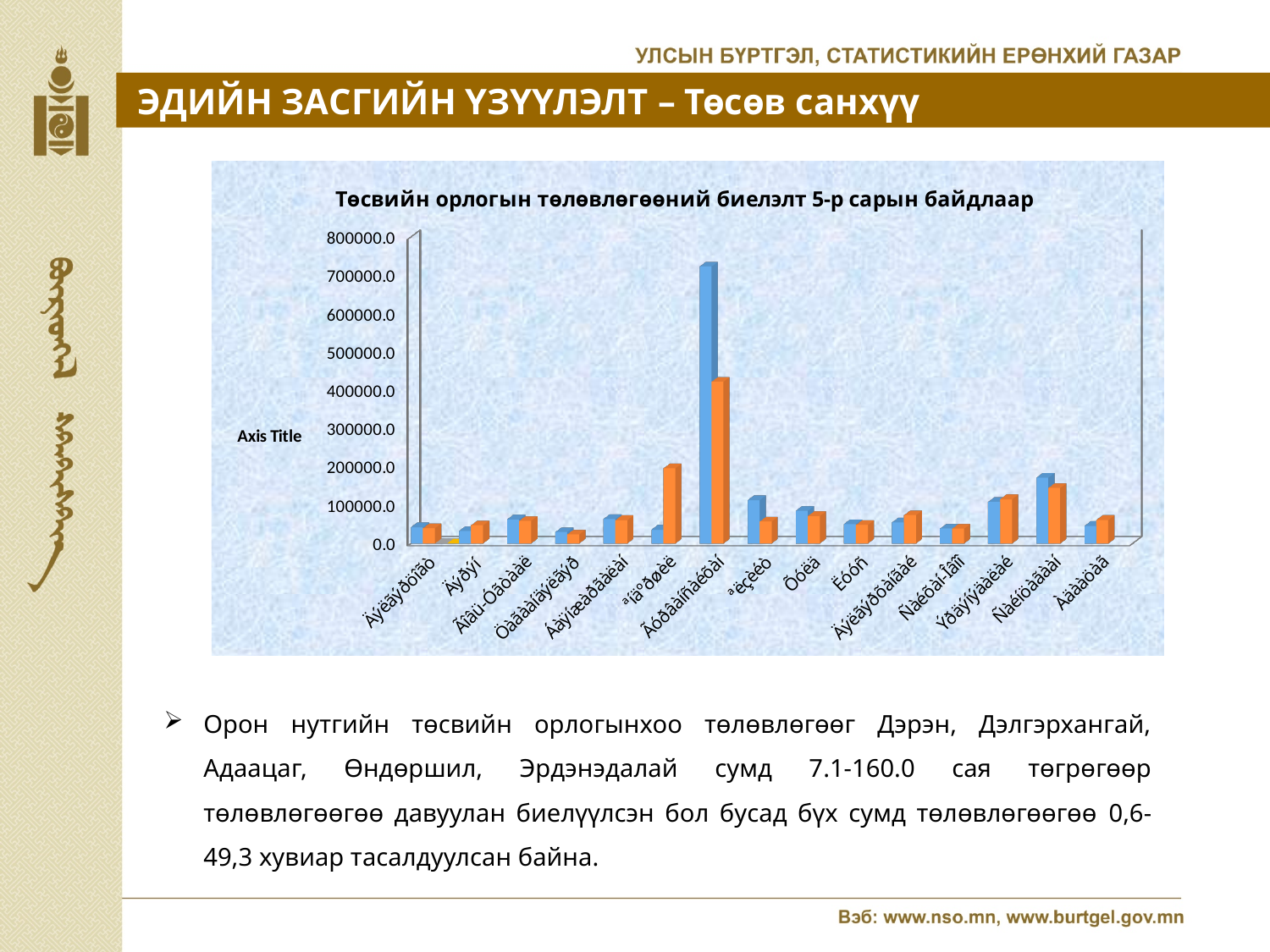
Is the tallest blue bar in the chart greater or less than 600000.0? greater How many categories are plotted along the x axis of the chart? 15 Is the tallest orange bar in the chart greater or less than 500000.0? less What is the highest value shown on the vertical axis of the chart? 800000.0 What kind of chart is shown on the slide? Bar chart In the category with the tallest bars, which bar is larger, the blue one or the orange one? The blue one How many data series (bars per category) are plotted in the chart? 2 Is the tallest orange bar in the chart greater or less than 300000.0? greater What is the title of the chart? Төсвийн орлогын төлөвлөгөөний биелэлт 5-р сарын байдлаар